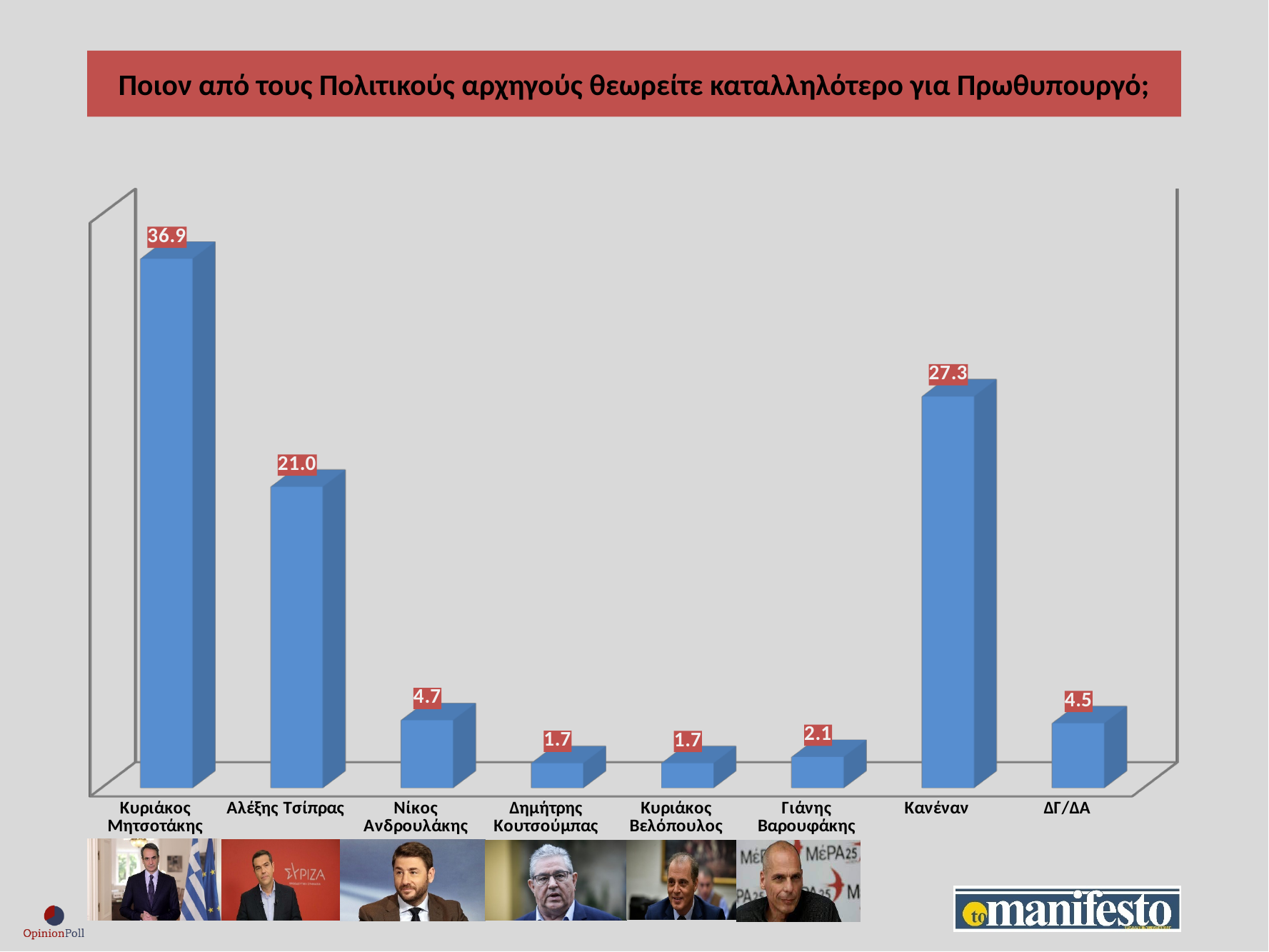
What kind of chart is shown on the slide? bar chart What is the value for Κυριάκος Μητσοτάκης? 36.9 What is the difference between the values for Κυριάκος Μητσοτάκης and Αλέξης Τσίπρας? 15.9 Which is larger, the value for Νίκος Ανδρουλάκης or the value for ΔΓ/ΔΑ? Νίκος Ανδρουλάκης What is the value for Αλέξης Τσίπρας? 21.0 What is the title of the chart? Ποιον από τους Πολιτικούς αρχηγούς θεωρείτε καταλληλότερο για Πρωθυπουργό; Which category has the highest value? Κυριάκος Μητσοτάκης How many categories are shown on the chart? 8 What is the value for Γιάνης Βαρουφάκης? 2.1 What is the value for Κανέναν? 27.3 What is the difference between the values for Κανέναν and Αλέξης Τσίπρας? 6.3 What is the value for ΔΓ/ΔΑ? 4.5